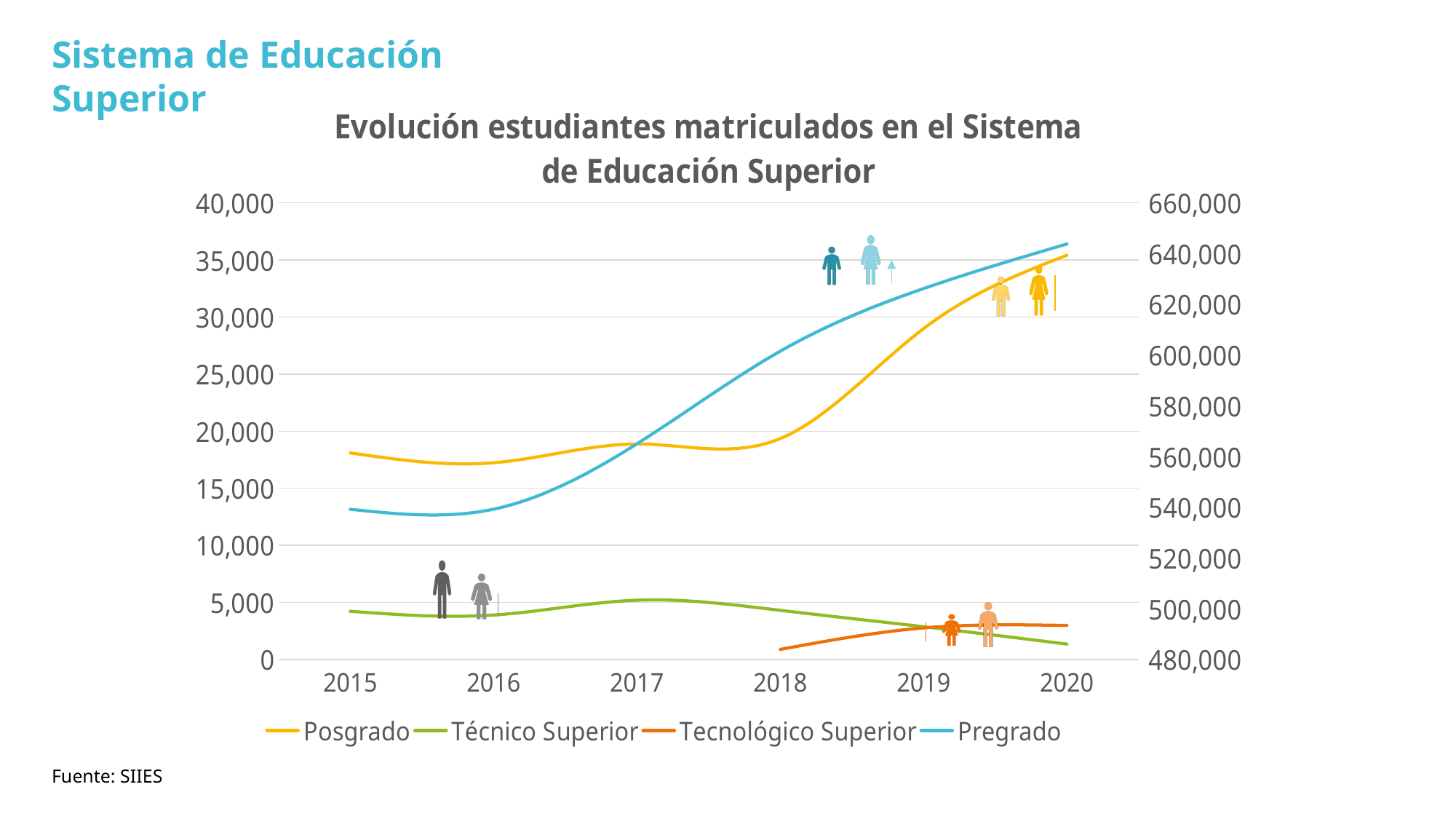
Does the Posgrado line rise or fall between 2015 and 2020? Rises What source is cited for the chart? SIIES In 2020, which is larger: Tecnológico Superior or Técnico Superior? Tecnológico Superior Is the value for Posgrado in 2015 greater or less than 15,000 on the left axis? greater How many series does the legend list? 4 What kind of chart is shown on the slide? Line chart Is the value for Técnico Superior in 2020 greater or less than 5,000 on the left axis? less What is the title of the chart? Evolución estudiantes matriculados en el Sistema de Educación Superior How many years are shown along the x axis? 6 Does the Técnico Superior line rise or fall between 2017 and 2020? Falls Is the value for Posgrado in 2020 greater or less than 30,000 on the left axis? greater Does the Pregrado line rise or fall between 2016 and 2020? Rises